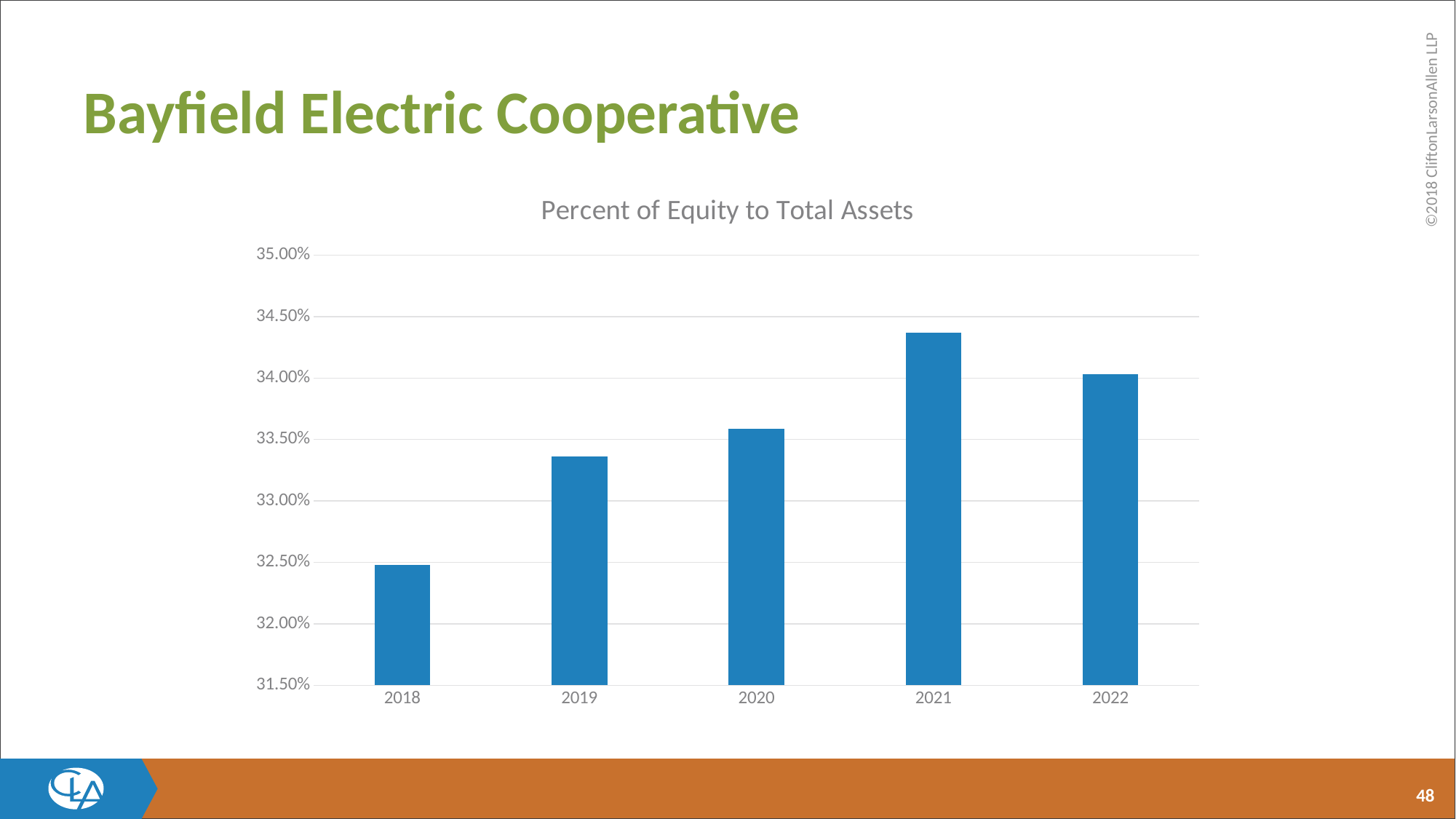
Is the value for 2019 greater or less than 33.50%? less Is the value for 2021 greater or less than 34.00%? greater What is the title of the chart? Percent of Equity to Total Assets What type of chart is shown on the slide? Bar chart Which year has the lowest percent of equity to total assets? 2018 Is the value for 2022 greater or less than 34.50%? less Does the percent of equity to total assets rise or fall from 2018 to 2021? Rise Which year has the highest percent of equity to total assets? 2021 How many years are shown on the x axis of the chart? 5 Which year has the larger value, 2019 or 2020? 2020 Which year has the larger value, 2021 or 2022? 2021